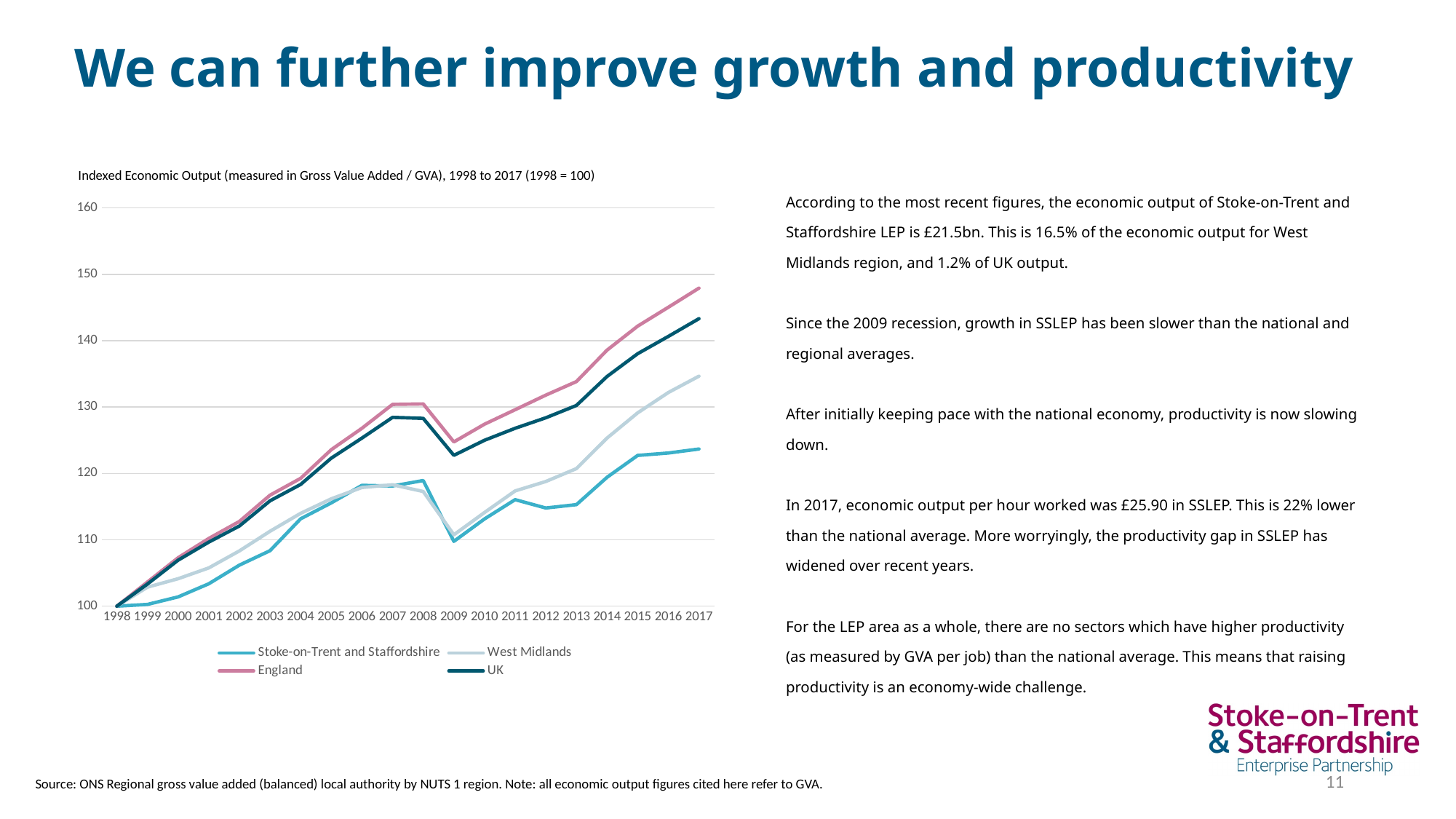
Is the value for Stoke-on-Trent and Staffordshire in 2009 greater or less than 120? less Is the value for West Midlands in 2017 greater or less than 130? greater Overall, do the series rise or fall from 1998 to 2017? Rise What is the indexed value for all series in 1998? 100 What kind of chart is shown on the slide? Line chart Is the value for England in 2017 greater or less than 140? greater How many years are plotted along the x axis? 20 Which series has the highest value in 2017? England How many series does the legend list? 4 Which series has the lowest value in 2017? Stoke-on-Trent and Staffordshire In 2017, which is larger: the value for England or the value for UK? England